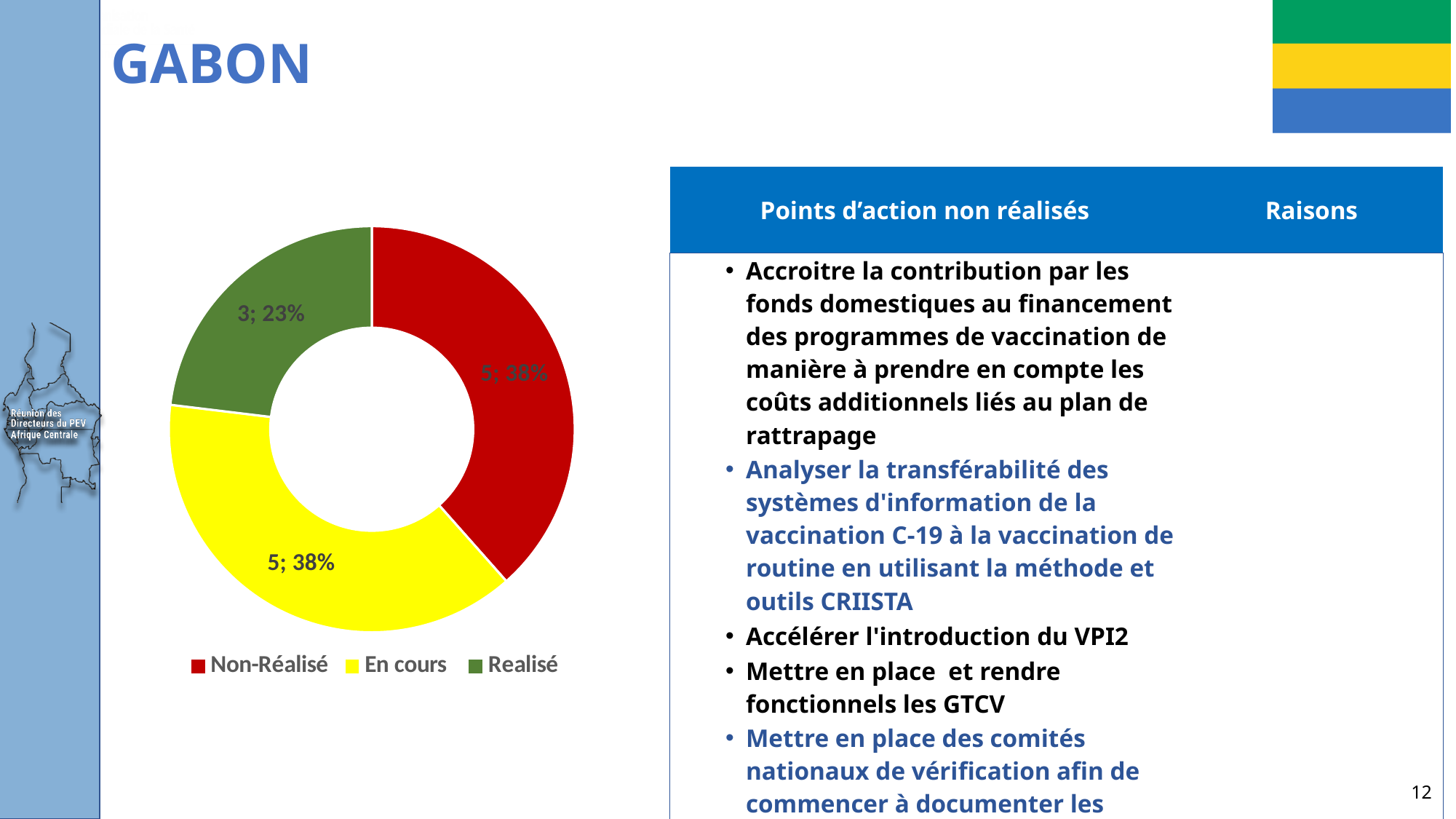
How many entries does the chart's legend list? 3 What share of the chart does the Realisé slice represent? 23% What is the difference between the counts for En cours and Realisé? 2 How many categories does the chart show? 3 What count is shown for the En cours slice? 5 What share of the chart does the En cours slice represent? 38% Which category has the smallest slice in the chart? Realisé What count is shown for the Realisé slice? 3 What count is shown for the Non-Réalisé slice? 5 Which is larger, the Non-Réalisé slice or the Realisé slice? Non-Réalisé Which colour represents En cours in the chart? Yellow What kind of chart is shown on the slide? Doughnut (pie) chart